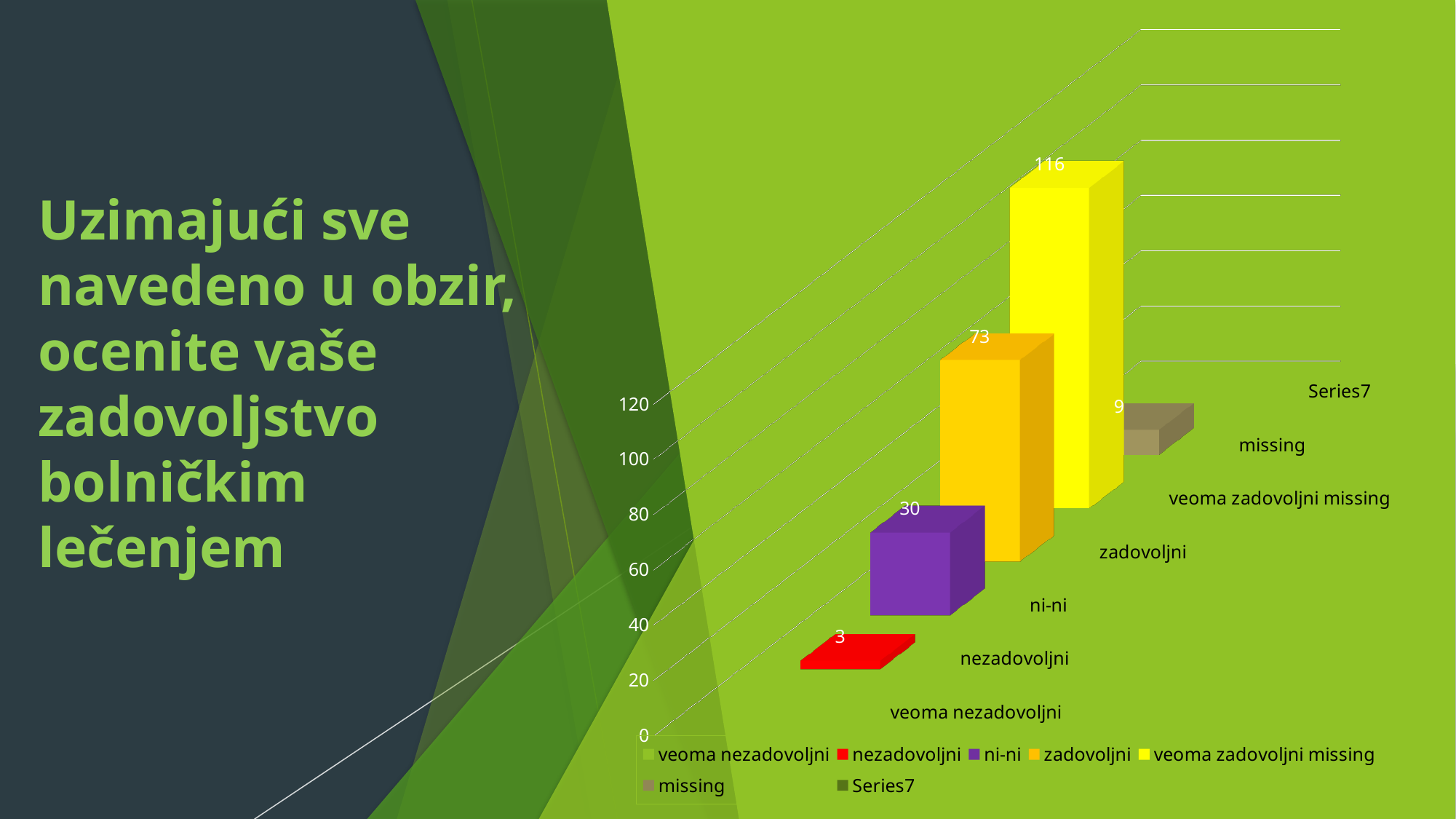
What is the value for nezadovoljni? 3 Which category has the highest value? veoma zadovoljni missing Which is larger, the value for zadovoljni or the value for ni-ni? zadovoljni What is the value for ni-ni? 30 What is the value for missing? 9 What is the difference between the values for ni-ni and nezadovoljni? 27 What is the value for veoma zadovoljni missing? 116 What kind of chart is shown on the slide? bar chart What is the value for zadovoljni? 73 How many entries does the legend list? 7 Is the value for veoma zadovoljni missing greater or less than 100? greater What is the difference between the values for veoma zadovoljni missing and zadovoljni? 43